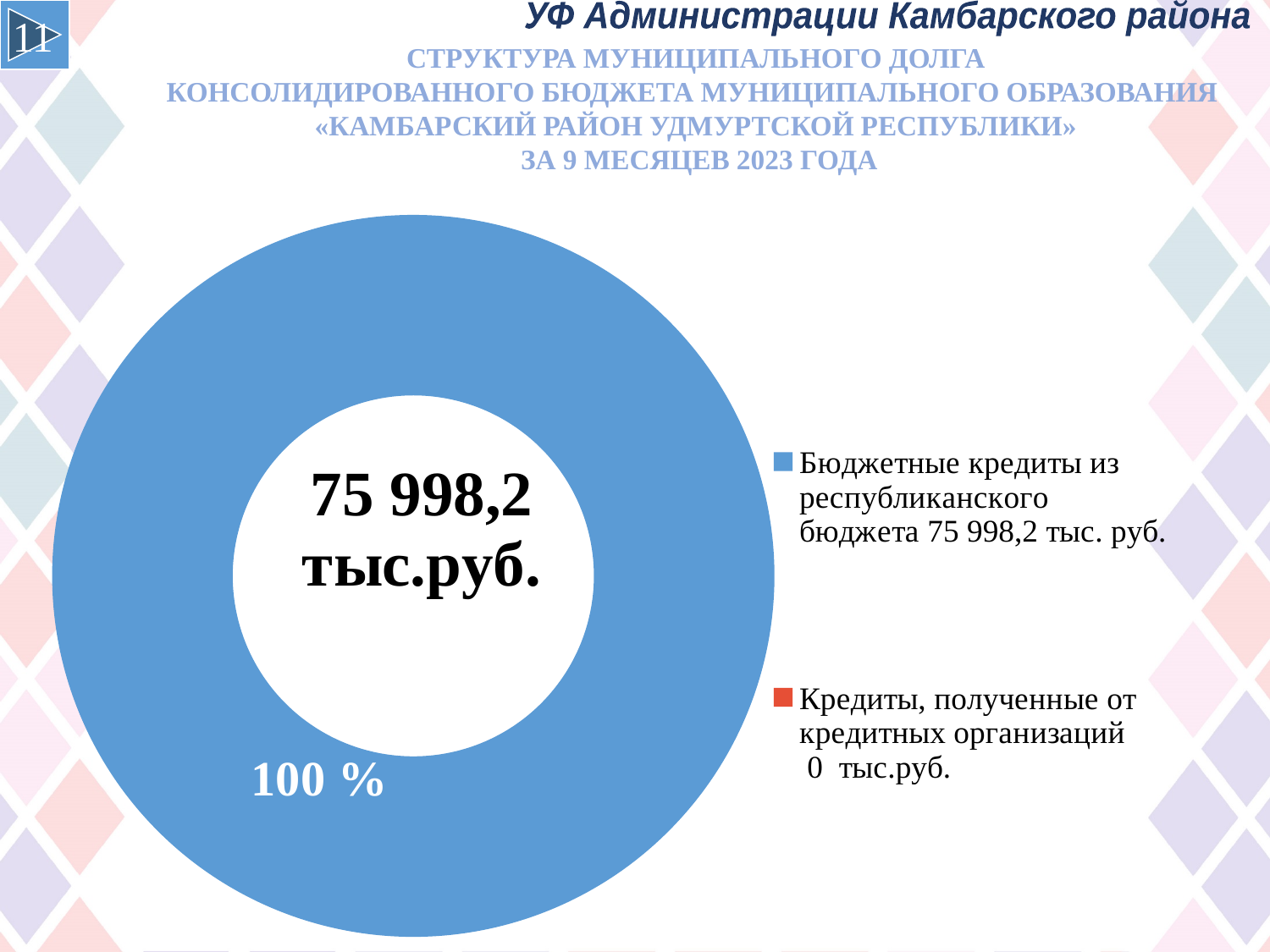
Which category has the larger value: «Бюджетные кредиты из республиканского бюджета» or «Кредиты, полученные от кредитных организаций»? Бюджетные кредиты из республиканского бюджета What value is shown for «Бюджетные кредиты из республиканского бюджета»? 75 998,2 тыс. руб. What kind of chart is shown on the slide? doughnut (pie) chart What total value is printed in the centre of the doughnut chart? 75 998,2 тыс.руб. What colour is the legend marker for «Кредиты, полученные от кредитных организаций»? red What is the difference between the value for «Бюджетные кредиты из республиканского бюджета» and «Кредиты, полученные от кредитных организаций»? 75 998,2 тыс. руб. What share of the chart does the blue slice represent? 100 % Which category has the highest value? Бюджетные кредиты из республиканского бюджета Which category has the lowest value? Кредиты, полученные от кредитных организаций How many entries does the chart legend list? 2 What value is shown for «Кредиты, полученные от кредитных организаций»? 0 тыс.руб. For what period does the chart title say the municipal debt structure is shown? за 9 месяцев 2023 года